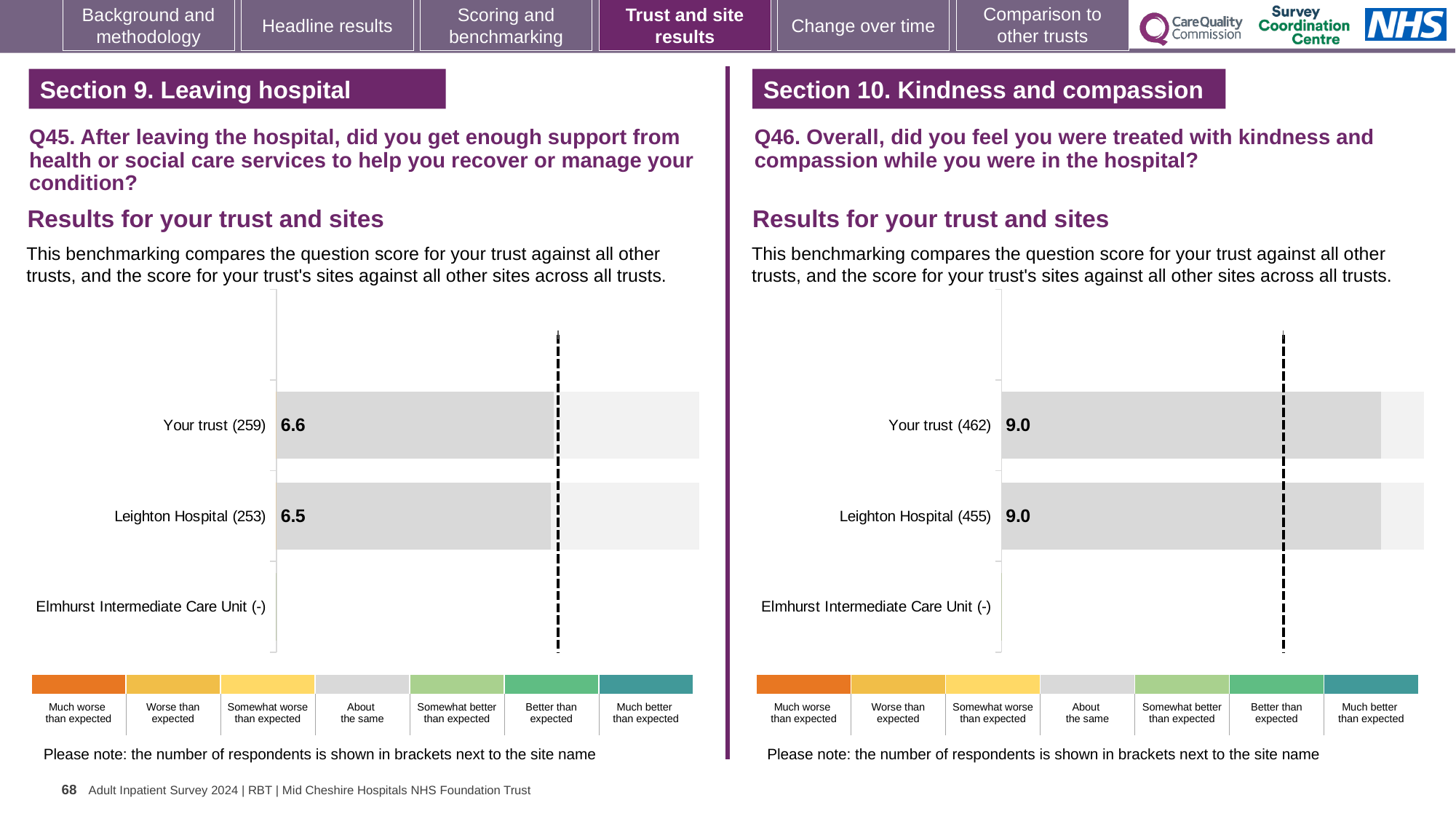
In the Q45 chart on the left, which has the higher score, Your trust or Leighton Hospital? Your trust What kind of chart is used for the Q45 results on the left? Bar chart In the Q46 chart on the right, how many respondents are shown in brackets for Leighton Hospital? 455 In the Q45 chart on the left, what is the difference between the score for Your trust and the score for Leighton Hospital? 0.1 In the Q46 chart on the right, which row has no score bar shown? Elmhurst Intermediate Care Unit In the Q45 chart on the left, how many respondents are shown in brackets for Your trust? 259 In the Q46 chart on the right, what is the score for Your trust? 9.0 In the Q45 chart on the left, what is the score for Leighton Hospital? 6.5 How many site/trust rows are listed in the Q46 chart on the right? 3 In the Q45 chart on the left, what is the score for Your trust? 6.6 In the Q46 chart on the right, what is the score for Leighton Hospital? 9.0